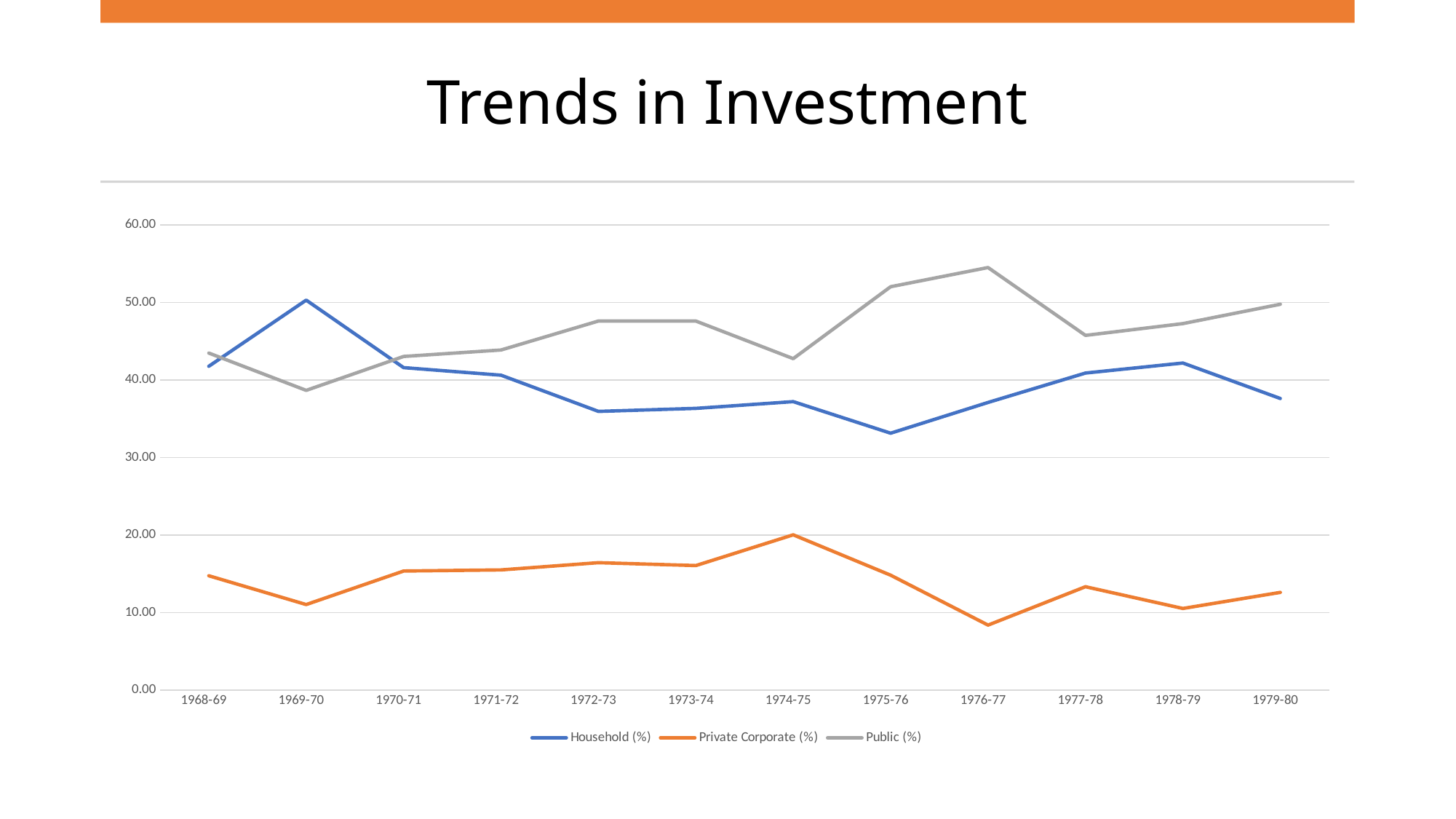
Is the Private Corporate (%) value for 1976-77 greater or less than 10? less In which year is the Private Corporate (%) line at its highest? 1974-75 In which year is the Household (%) line at its lowest? 1975-76 What kind of chart is shown on the slide? line chart Does the Private Corporate (%) line rise or fall from 1974-75 to 1976-77? fall In 1969-70, which is larger: Household (%) or Public (%)? Household (%) How many years are plotted along the x axis? 12 Is the Household (%) value for 1972-73 greater or less than 40? less In which year does the Public (%) line reach its highest value? 1976-77 How many series does the legend list? 3 Is the Public (%) value for 1976-77 greater or less than 50? greater In which year is the Private Corporate (%) line at its lowest? 1976-77